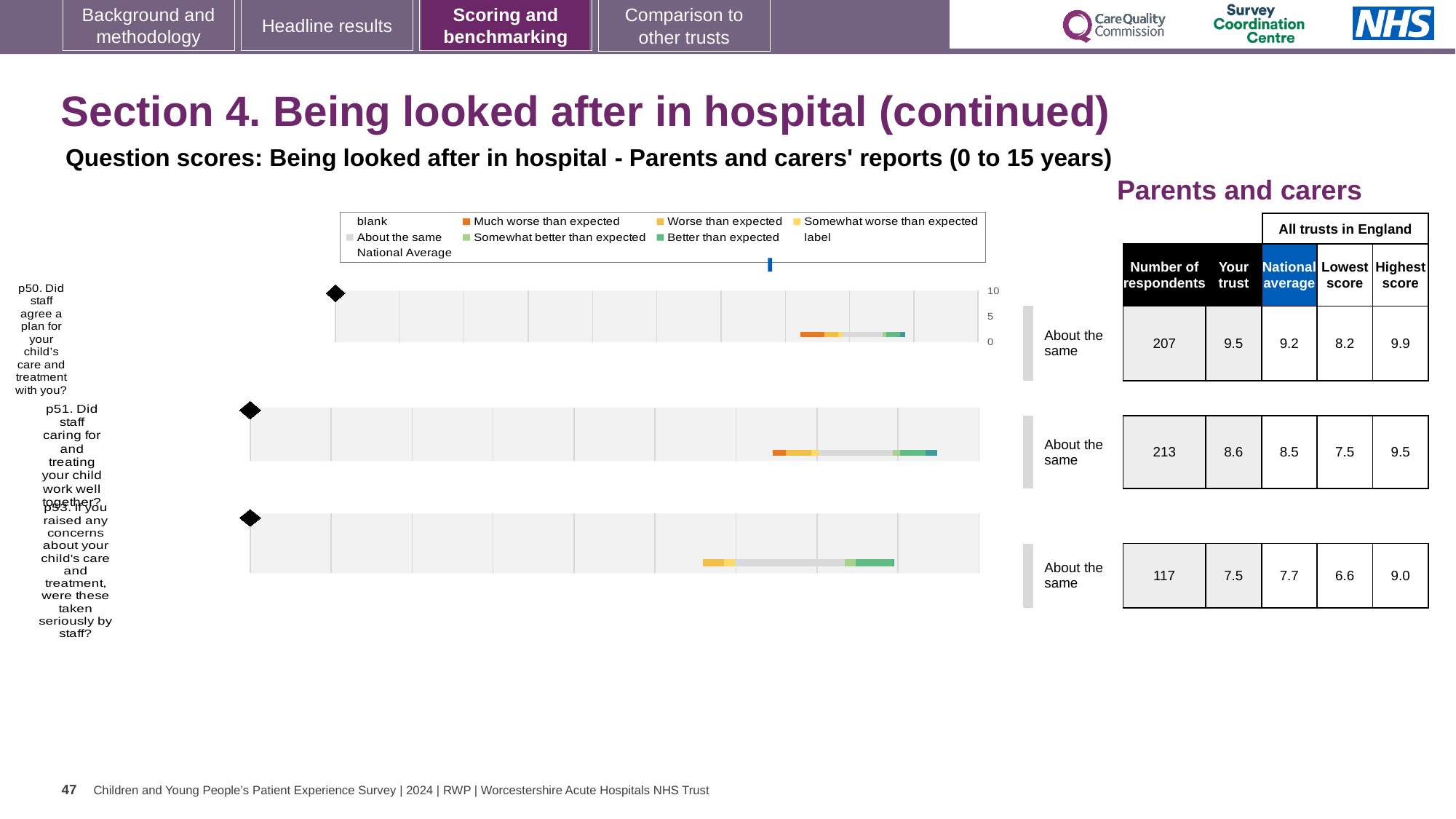
What is the highest score among all trusts in England for p53? 9.0 Which question has the highest 'Your trust' score? p50 What colour does the legend use for 'Much worse than expected'? orange What is the national average score for p51 (Did staff caring for and treating your child work well together?)? 8.5 How many questions are plotted in the charts on this slide? 3 What benchmark category is shown for p50? About the same For p51, which is larger: the 'Your trust' score or the national average? Your trust What kind of chart is used to show the question scores on this slide? bar chart How many respondents are there for p53 (If you raised any concerns about your child's care and treatment, were these taken seriously by staff?)? 117 What is the 'Your trust' score for p50 (Did staff agree a plan for your child's care and treatment with you?)? 9.5 Which question has the lowest 'Your trust' score? p53 What is the difference between the highest score and the lowest score for p50? 1.7